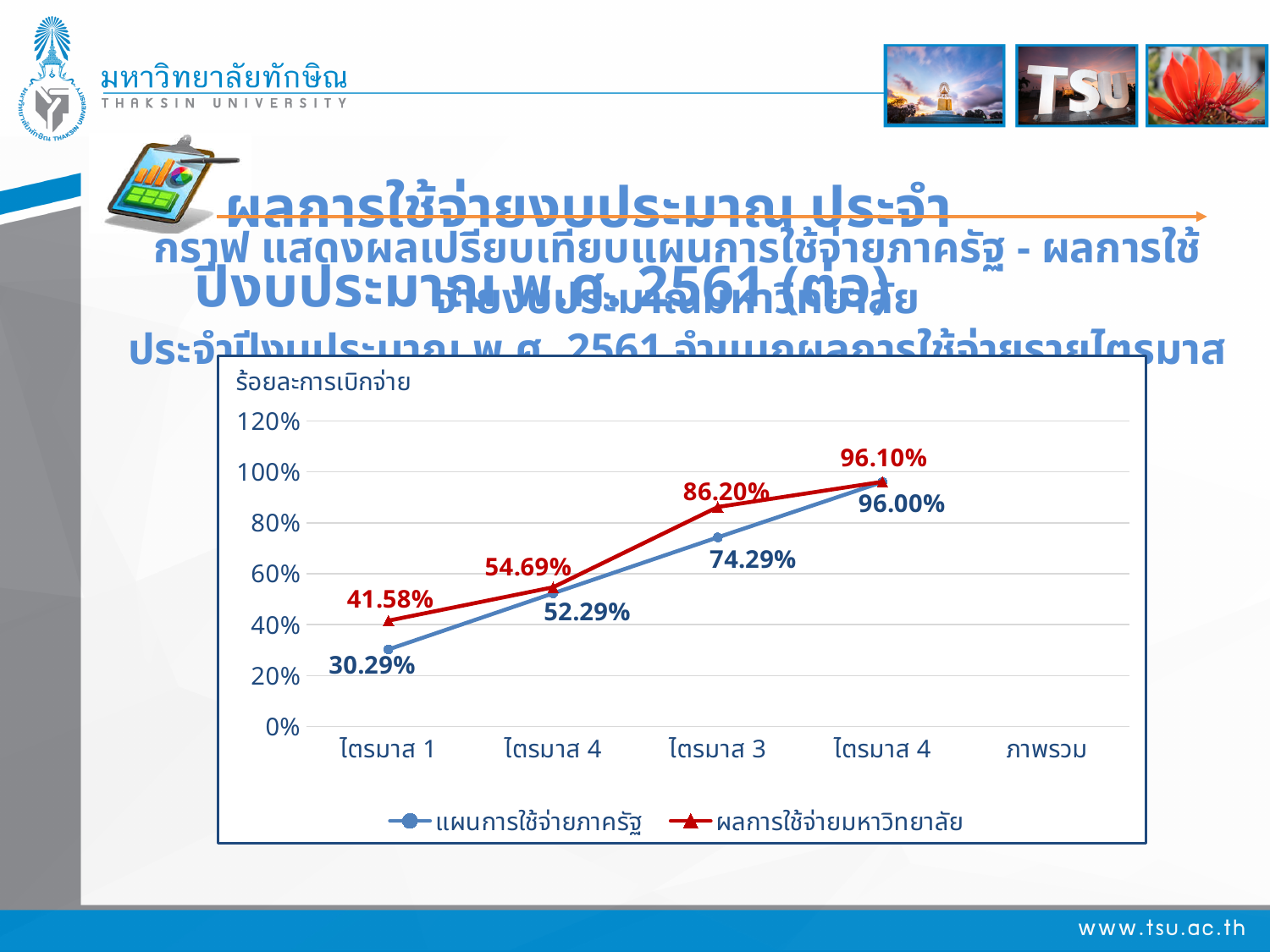
What kind of chart is shown on the slide? line chart What is the value of แผนการใช้จ่ายภาครัฐ for ไตรมาส 1? 30.29% What is the difference between ผลการใช้จ่ายมหาวิทยาลัย and แผนการใช้จ่ายภาครัฐ for ไตรมาส 1? 11.29% Which series has the higher value for ไตรมาส 3, แผนการใช้จ่ายภาครัฐ or ผลการใช้จ่ายมหาวิทยาลัย? ผลการใช้จ่ายมหาวิทยาลัย How many categories are shown on the x axis? 5 What is the label shown on the y axis of the chart? ร้อยละการเบิกจ่าย What is the value of ผลการใช้จ่ายมหาวิทยาลัย for ไตรมาส 3? 86.20% How many series does the legend list? 2 What is the value of แผนการใช้จ่ายภาครัฐ for ไตรมาส 3? 74.29% What is the value of ผลการใช้จ่ายมหาวิทยาลัย for ไตรมาส 1? 41.58% Do the values of แผนการใช้จ่ายภาครัฐ rise or fall from ไตรมาส 1 to the fourth category? rise What is the value of ผลการใช้จ่ายมหาวิทยาลัย at the fourth category (the second ไตรมาส 4)? 96.10%